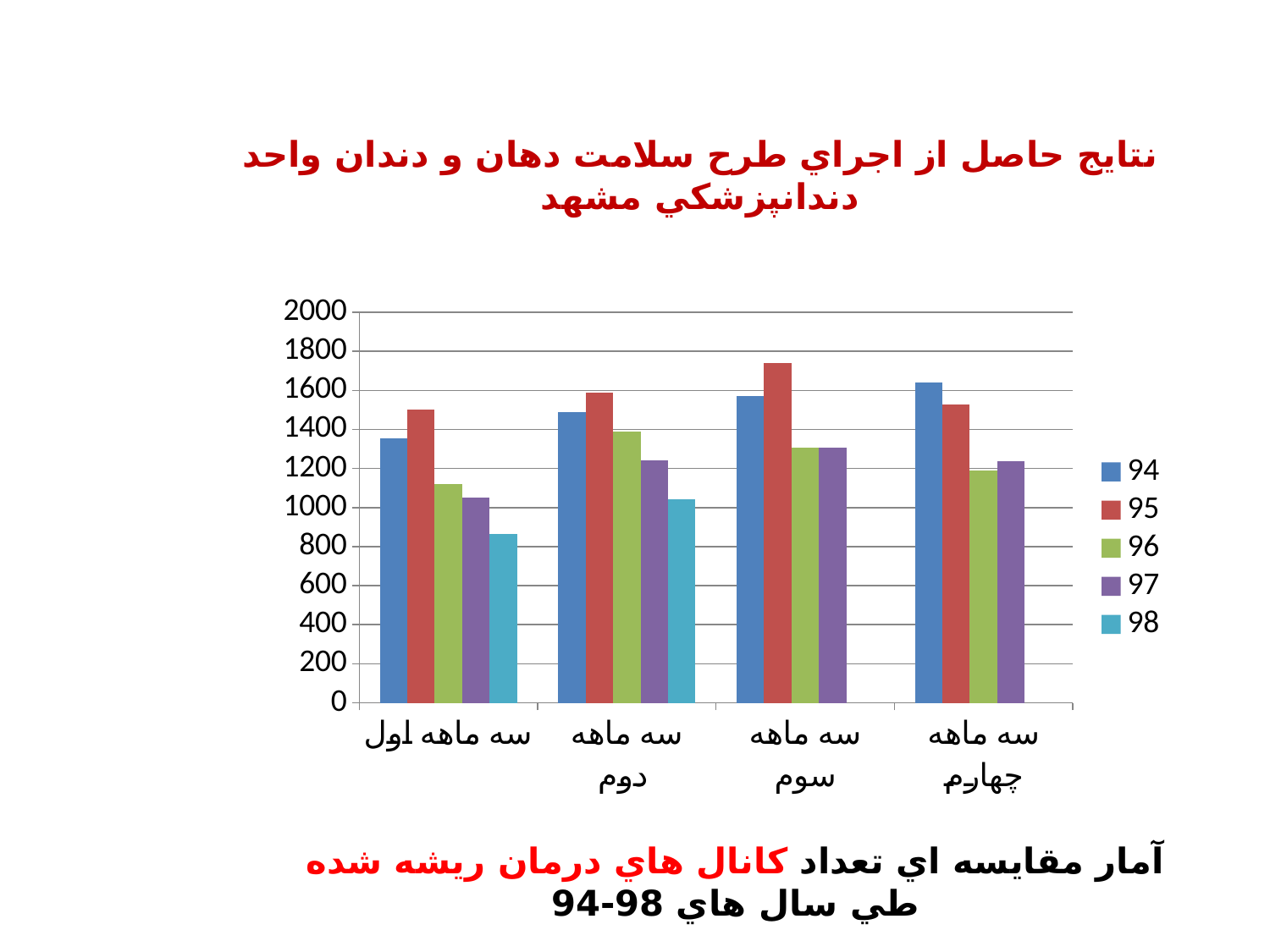
Which is larger in سه ماهه اول: the value for series 94 or series 96? 94 Which series is shown in light blue in the legend? 98 Is the value for series 98 in سه ماهه اول greater or less than 1000? less Which series has the highest value in سه ماهه چهارم? 94 What kind of chart is shown on the slide? bar chart Is the value for series 94 in سه ماهه چهارم greater or less than 1600? greater How many categories are shown on the x axis? 4 Which series has the highest value in سه ماهه سوم? 95 How many series does the legend list? 5 Is the value for series 95 in سه ماهه سوم greater or less than 1600? greater Which series has the lowest value in سه ماهه دوم? 98